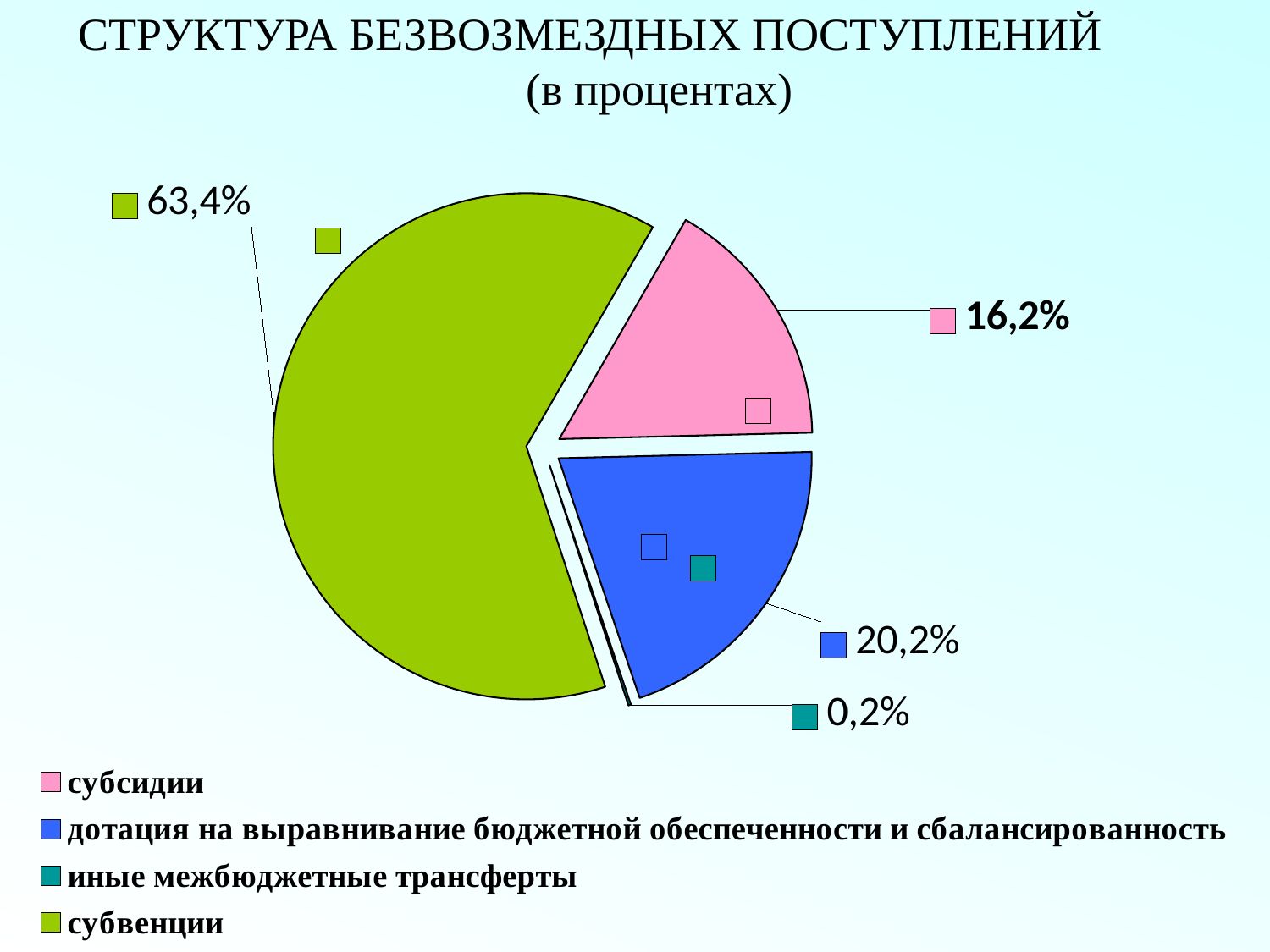
What is the share for субсидии? 16,2% What is the share for субвенции? 63,4% What is the share for дотация на выравнивание бюджетной обеспеченности и сбалансированность? 20,2% Which category has the largest share of the pie? субвенции What kind of chart is shown on the slide? pie chart What colour is the slice for субсидии? pink How many slices does the pie chart have? 4 What is the share for иные межбюджетные трансферты? 0,2% What is the difference between the shares for дотация на выравнивание бюджетной обеспеченности и сбалансированность and субсидии? 4,0% Which is larger, the share for субсидии or the share for дотация на выравнивание бюджетной обеспеченности и сбалансированность? дотация на выравнивание бюджетной обеспеченности и сбалансированность What is the difference between the shares for субвенции and субсидии? 47,2% Which category has the smallest share of the pie? иные межбюджетные трансферты